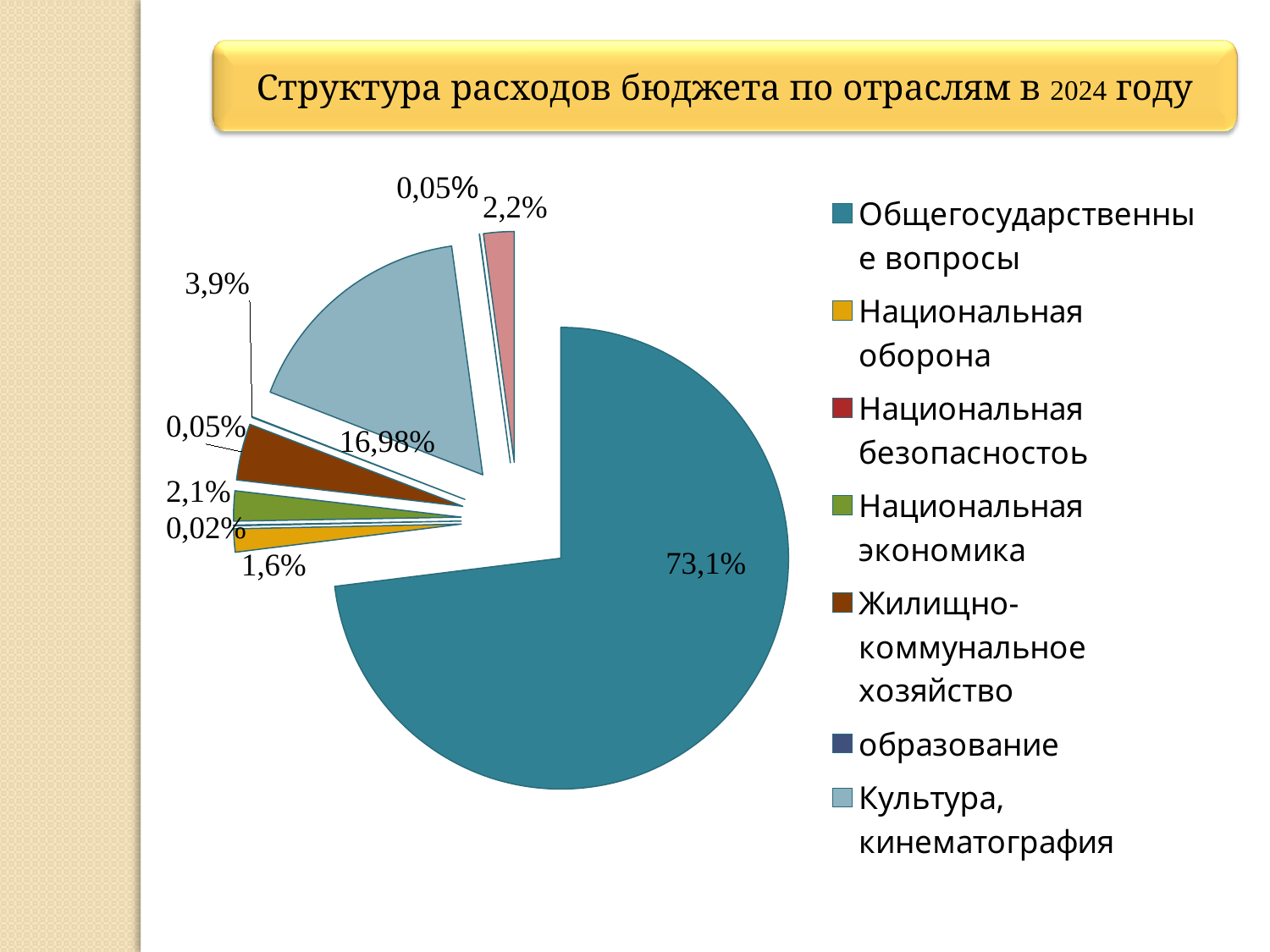
What share of the pie is labelled for Культура, кинематография? 16,98% Which slice is larger: Национальная экономика or Национальная оборона? Национальная экономика Which slice is larger: Культура, кинематография or Жилищно-коммунальное хозяйство? Культура, кинематография How many entries does the legend list? 7 What kind of chart is shown on the slide? Pie chart Which category has the largest slice of the pie? Общегосударственные вопросы What share of the pie is labelled for Национальная экономика? 2,1% What share of the pie is labelled for Жилищно-коммунальное хозяйство? 3,9% What is the difference between the shares of Жилищно-коммунальное хозяйство and Национальная экономика? 1,8% What is the title of the chart? Структура расходов бюджета по отраслям в 2024 году What share of the pie is labelled for Национальная оборона? 1,6% What share of the pie is labelled for Общегосударственные вопросы? 73,1%